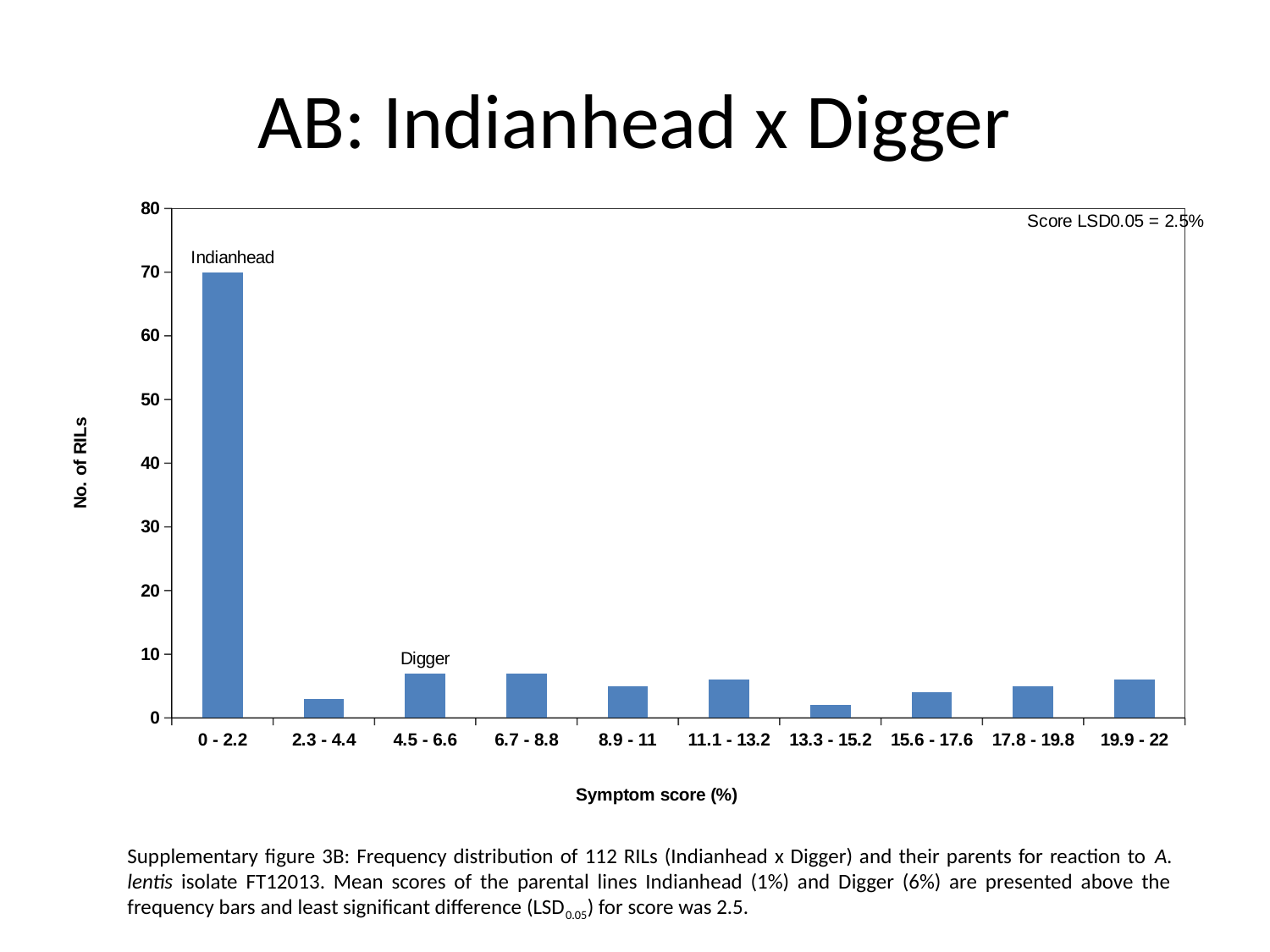
Is the number of RILs for the 0 - 2.2 category greater or less than 60? greater Which has more RILs, the 4.5 - 6.6 category or the 13.3 - 15.2 category? 4.5 - 6.6 Is the number of RILs for the 2.3 - 4.4 category greater or less than 10? less Which symptom score category has the lowest number of RILs? 13.3 - 15.2 What is the title of the x axis? Symptom score (%) What is the number of RILs for the 0 - 2.2 symptom score category? 70 Which parental line is labelled above the 0 - 2.2 bar? Indianhead How many symptom score categories are shown on the x axis? 10 Which symptom score category has the highest number of RILs? 0 - 2.2 Is the number of RILs for the 13.3 - 15.2 category greater or less than 10? less What kind of chart is shown on the slide? bar chart Which has more RILs, the 0 - 2.2 category or the 2.3 - 4.4 category? 0 - 2.2